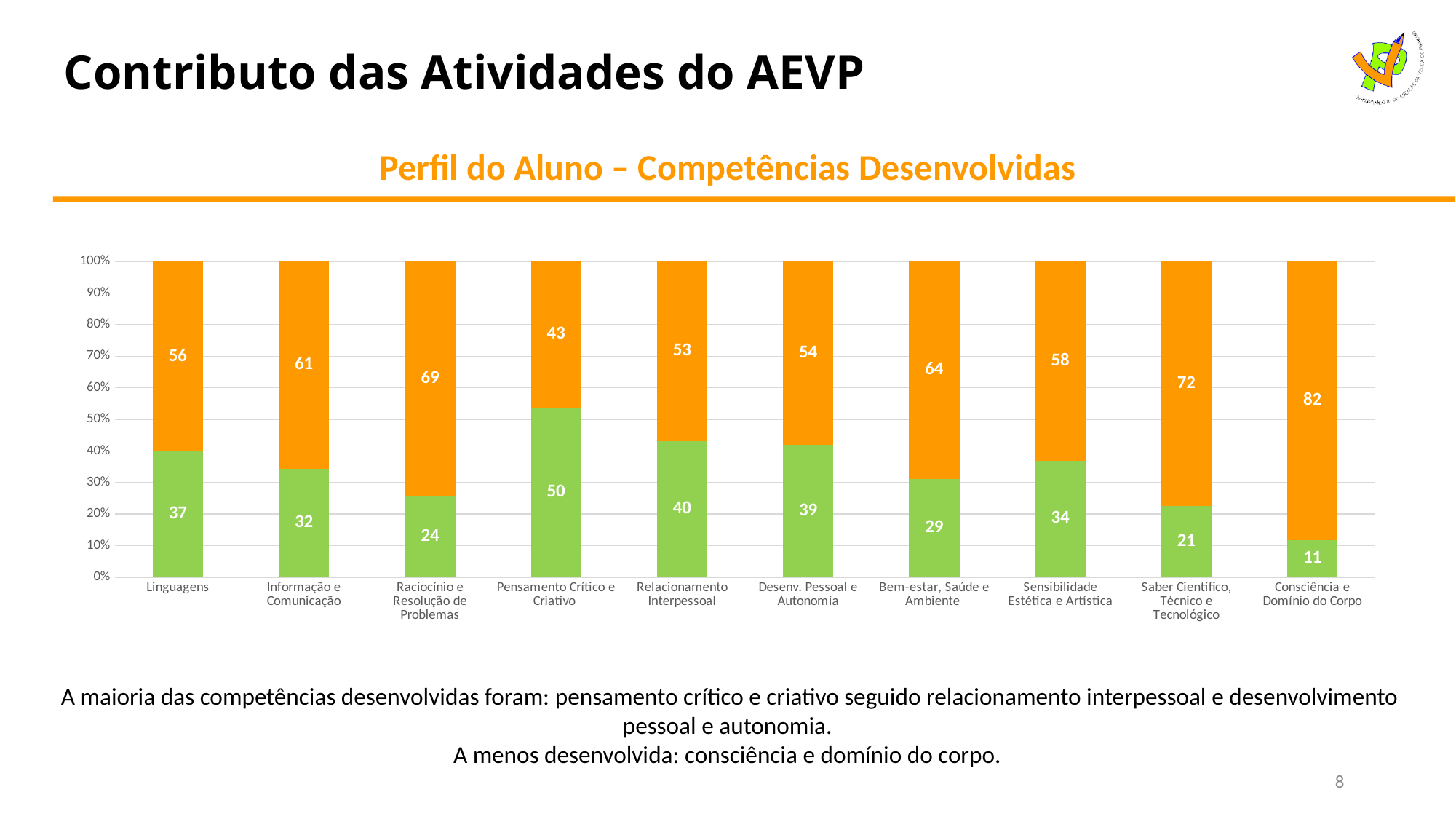
What kind of chart is shown on the slide? Stacked bar chart What is the value of the green segment for Linguagens? 37 Is the top of the green segment for Consciência e Domínio do Corpo greater or less than 20%? less What is the value of the orange segment for Saber Científico, Técnico e Tecnológico? 72 How many categories are shown on the x axis? 10 Which category has the highest green segment value? Pensamento Crítico e Criativo Which category has the highest orange segment value? Consciência e Domínio do Corpo Which has a larger green segment value, Linguagens or Informação e Comunicação? Linguagens Which category has the lowest green segment value? Consciência e Domínio do Corpo What is the value of the orange segment for Consciência e Domínio do Corpo? 82 What is the title of the chart? Perfil do Aluno – Competências Desenvolvidas What is the difference between the orange and green values for Saber Científico, Técnico e Tecnológico? 51